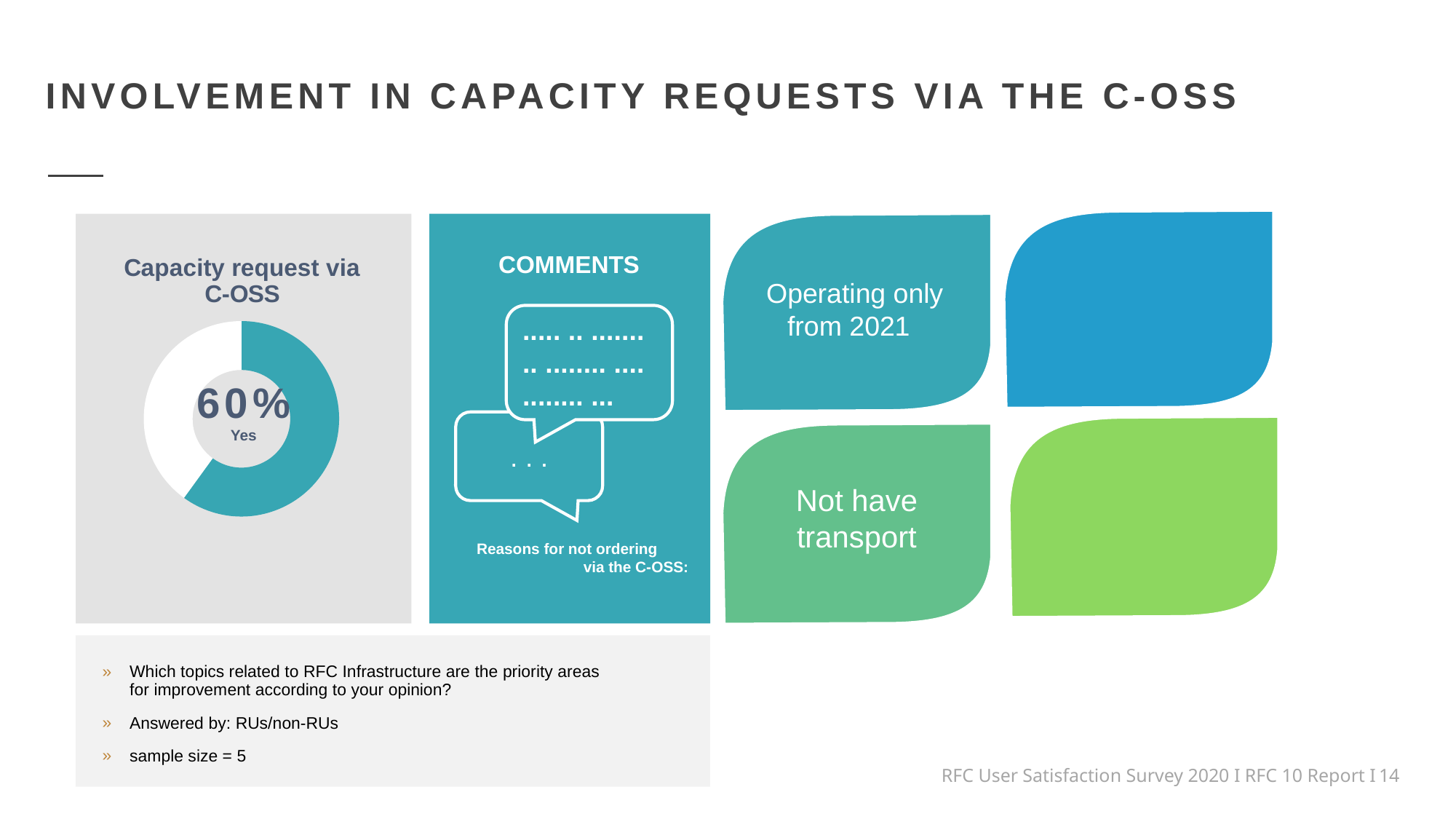
What kind of chart is used to show the Capacity request via C-OSS result? Pie chart (donut) In the Capacity request via C-OSS chart, is the Yes slice larger or smaller than the remaining slice? larger What is the sample size stated for the Capacity request via C-OSS chart? 5 What is the title of the chart on the left of the slide? Capacity request via C-OSS What percentage of respondents answered Yes in the Capacity request via C-OSS chart? 60% In the Capacity request via C-OSS chart, is the Yes share greater or less than 50%? greater Which response is labelled inside the Capacity request via C-OSS donut chart? Yes